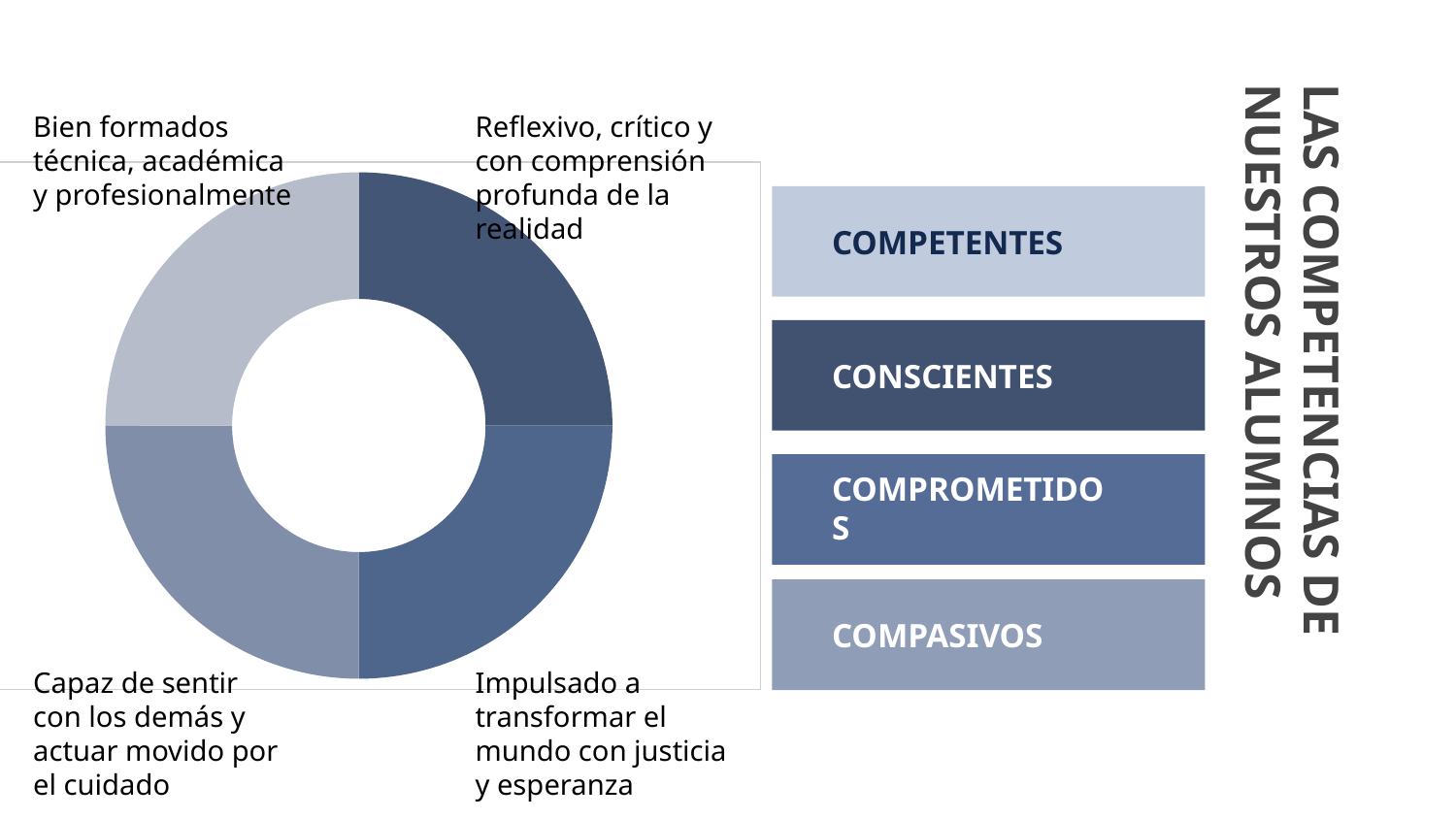
How many segments does the doughnut chart have? 4 What kind of chart is shown on the left of the slide? doughnut chart Which competency does the dark navy segment of the doughnut chart correspond to? CONSCIENTES Are the four segments of the doughnut chart equal in size? yes What is the title of the slide containing the doughnut chart? LAS COMPETENCIAS DE NUESTROS ALUMNOS